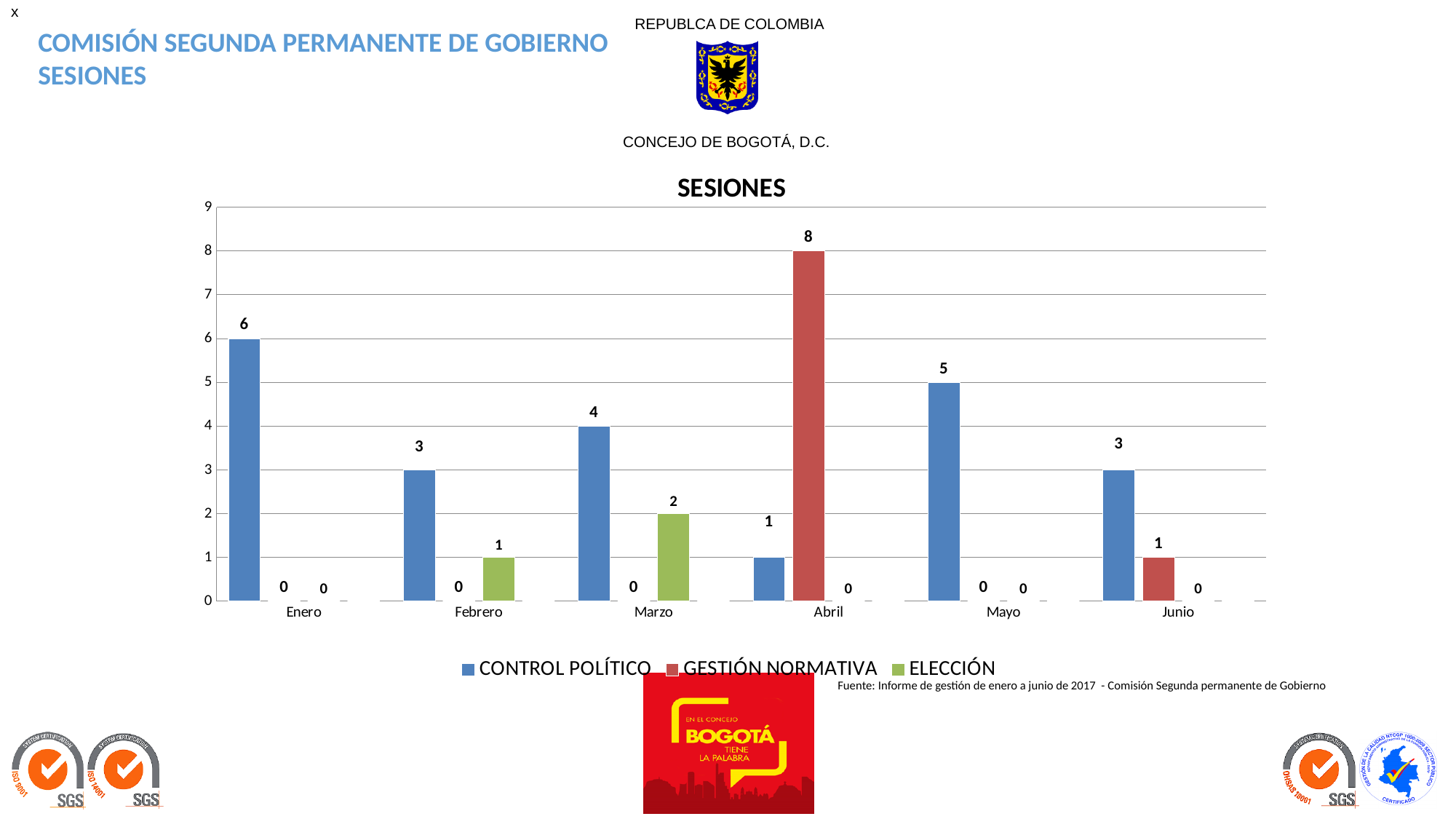
In which month is the CONTROL POLÍTICO value lowest? Abril How many series does the legend list? 3 What is the value for GESTIÓN NORMATIVA in Abril? 8 What is the value for CONTROL POLÍTICO in Mayo? 5 What kind of chart is shown? Bar chart Which is larger: CONTROL POLÍTICO in Marzo or CONTROL POLÍTICO in Febrero? CONTROL POLÍTICO in Marzo What is the value for ELECCIÓN in Marzo? 2 What is the title of the chart? SESIONES What is the value for CONTROL POLÍTICO in Enero? 6 In which month is the CONTROL POLÍTICO value highest? Enero How many months are shown on the x axis? 6 What is the difference between the GESTIÓN NORMATIVA value in Abril and the CONTROL POLÍTICO value in Abril? 7